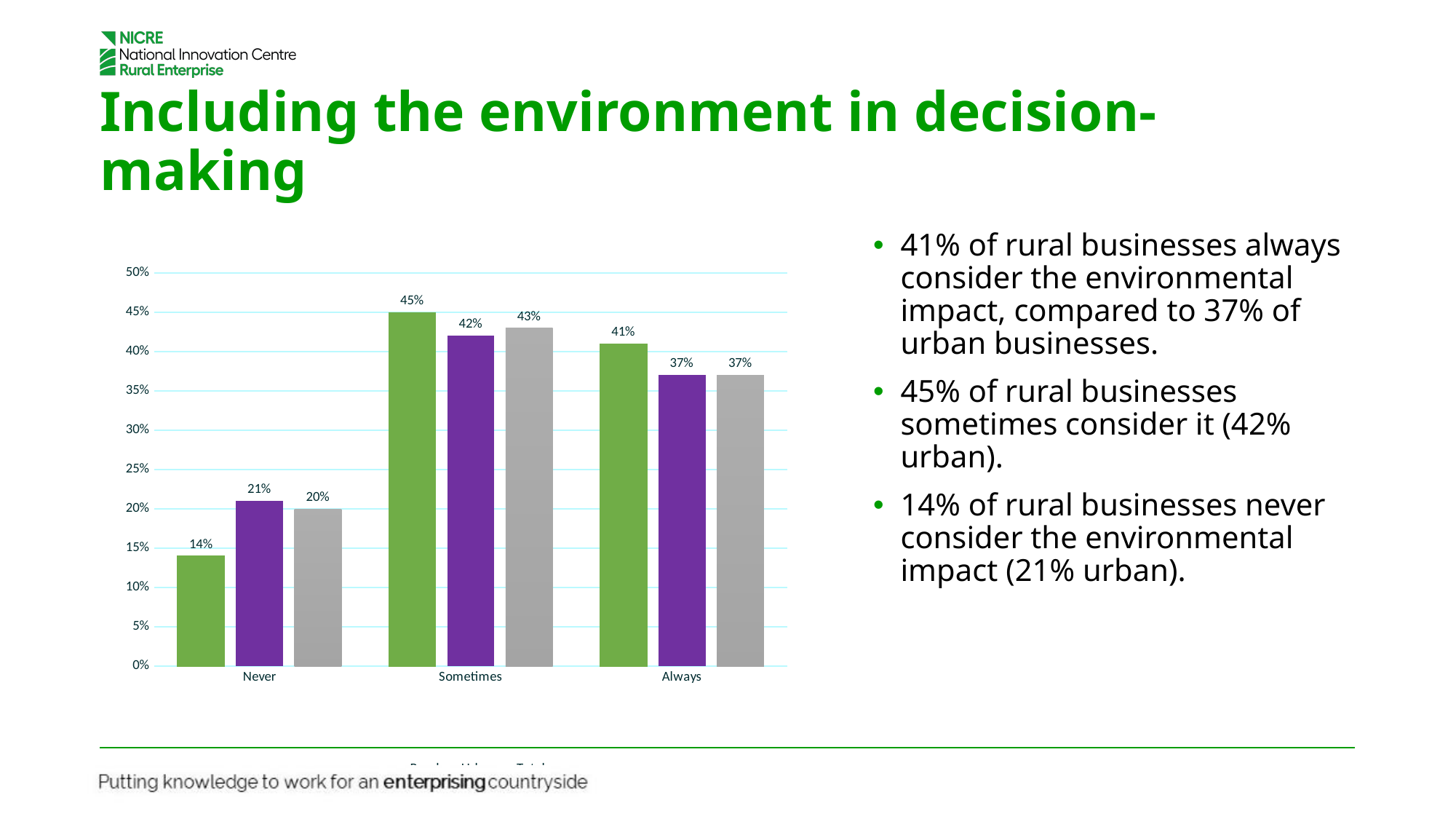
What is the highest value shown on the y axis of the chart? 50% Which category has the lowest value for the green bar? Never What is the value of the grey bar for the Sometimes category? 43% What is the value of the green bar for the Sometimes category? 45% How many categories are shown on the x axis of the chart? 3 Which category has the highest value for the purple bar? Sometimes What is the value of the grey bar for the Always category? 37% What is the difference between the green bar and the purple bar in the Always category? 4% What is the value of the purple bar for the Never category? 21% What is the difference between the purple bar and the green bar in the Never category? 7% In the Never category, which is larger: the green bar or the purple bar? the purple bar What type of chart is shown on the slide? bar chart